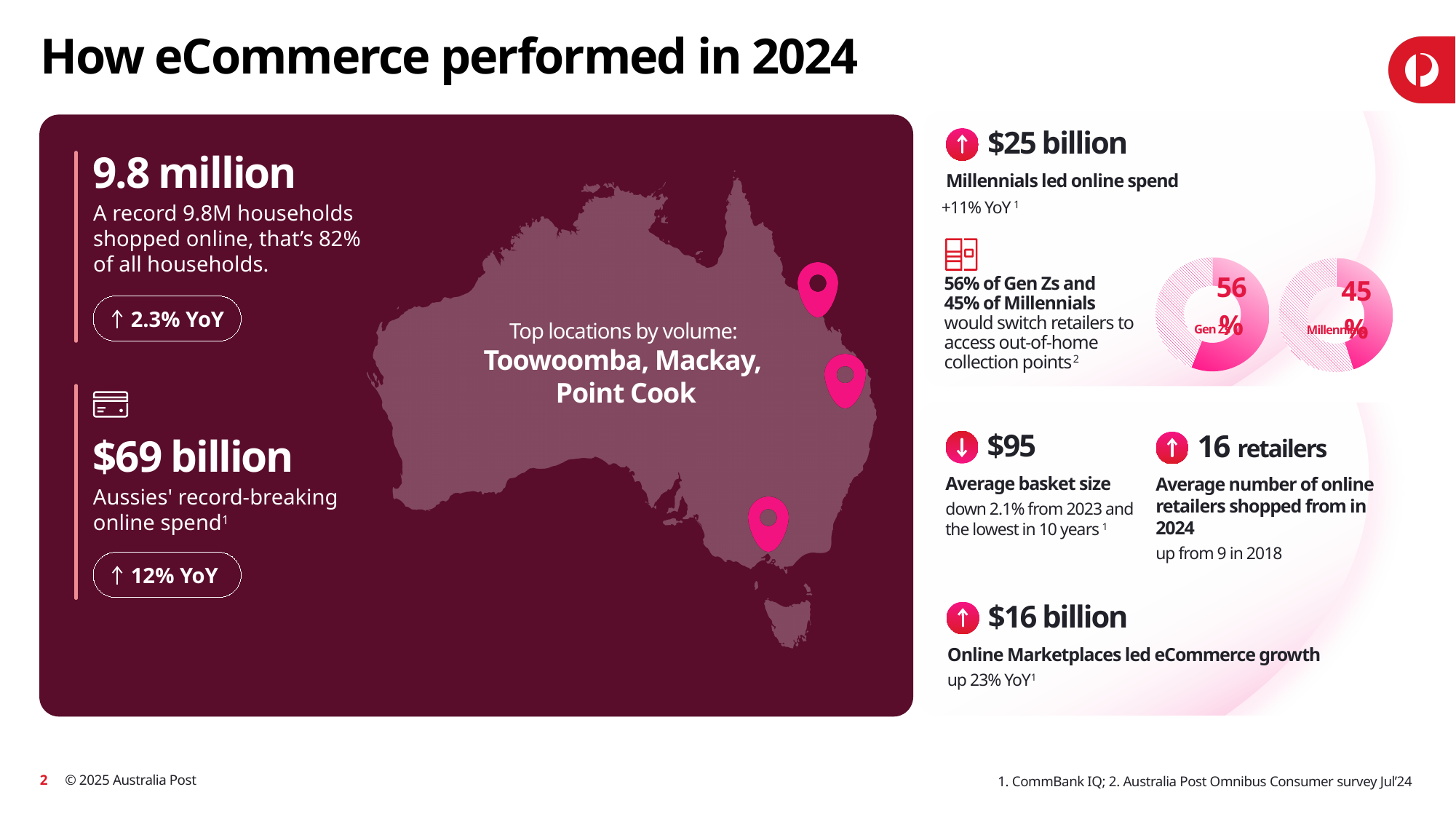
Comparing the two donut charts, which group has the higher percentage, Gen Z or Millennials? Gen Z How many donut charts are shown on the slide? 2 What is the difference in percentage points between the Gen Z donut chart value and the Millennials donut chart value? 11 percentage points What colour is the filled segment in the donut charts? Pink What do the two donut charts represent, according to the text beside them? The share of Gen Zs and Millennials who would switch retailers to access out-of-home collection points Is the value in the Millennials donut chart greater or less than 50%? less Is the value in the Gen Z donut chart greater or less than 50%? greater What kind of chart is used to show the Gen Z and Millennials percentages? Donut (pie) chart In the Millennials donut chart, what percentage is shown? 45% Which of the two donut charts shows the lower percentage? Millennials In the Gen Z donut chart, what percentage is shown? 56%